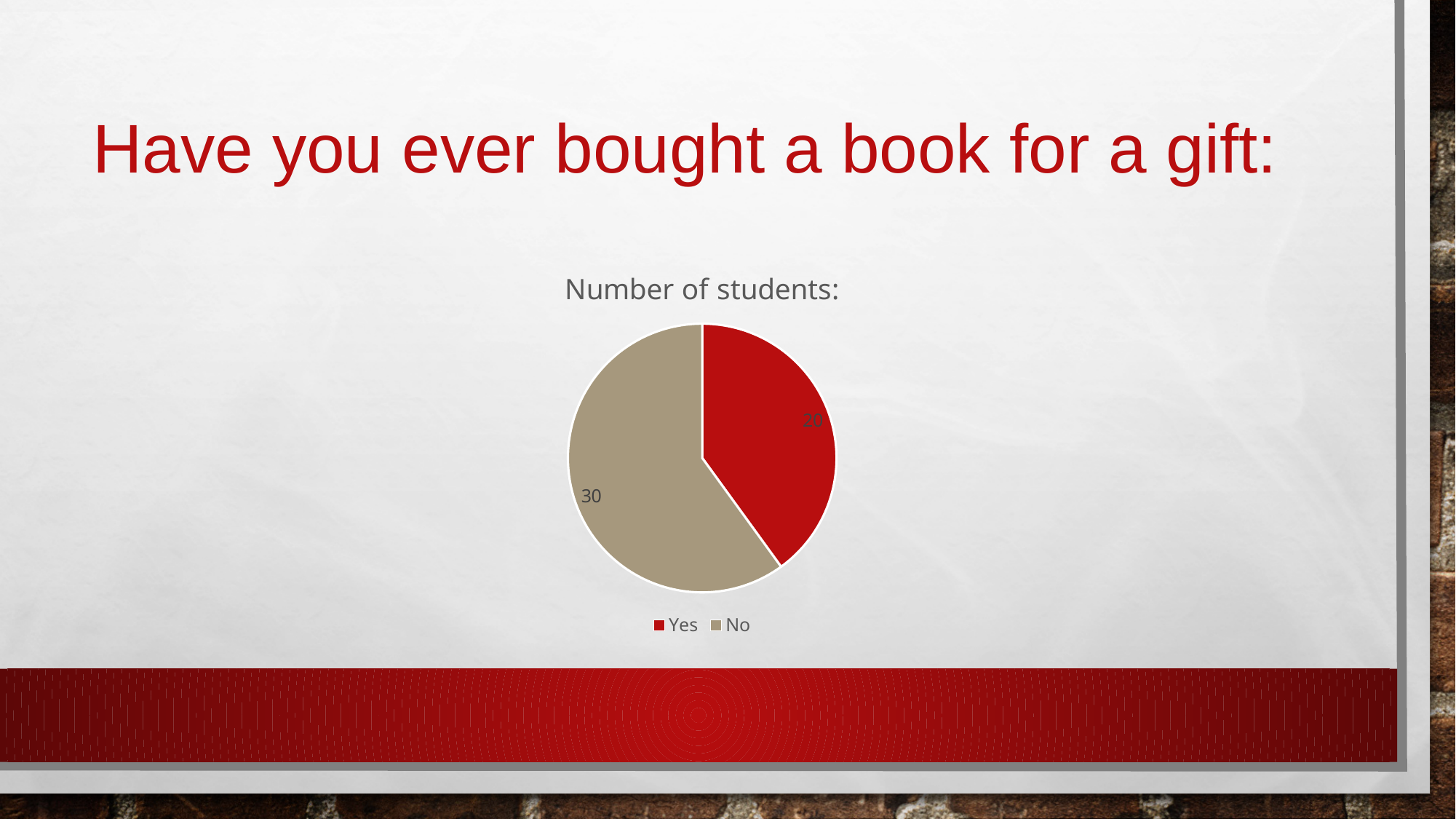
Which category has the smallest slice? Yes What type of chart is shown on the slide? pie chart What is the total number of students represented in the pie chart? 50 Which is larger, the Yes slice or the No slice? No How many students answered Yes? 20 What is the difference between the number of No and Yes answers? 10 How many students answered No? 30 What share of the pie does the Yes slice represent? 40% What colour is the Yes slice? red Which category has the largest slice? No What is the title of the chart? Number of students: How many categories does the pie chart have? 2